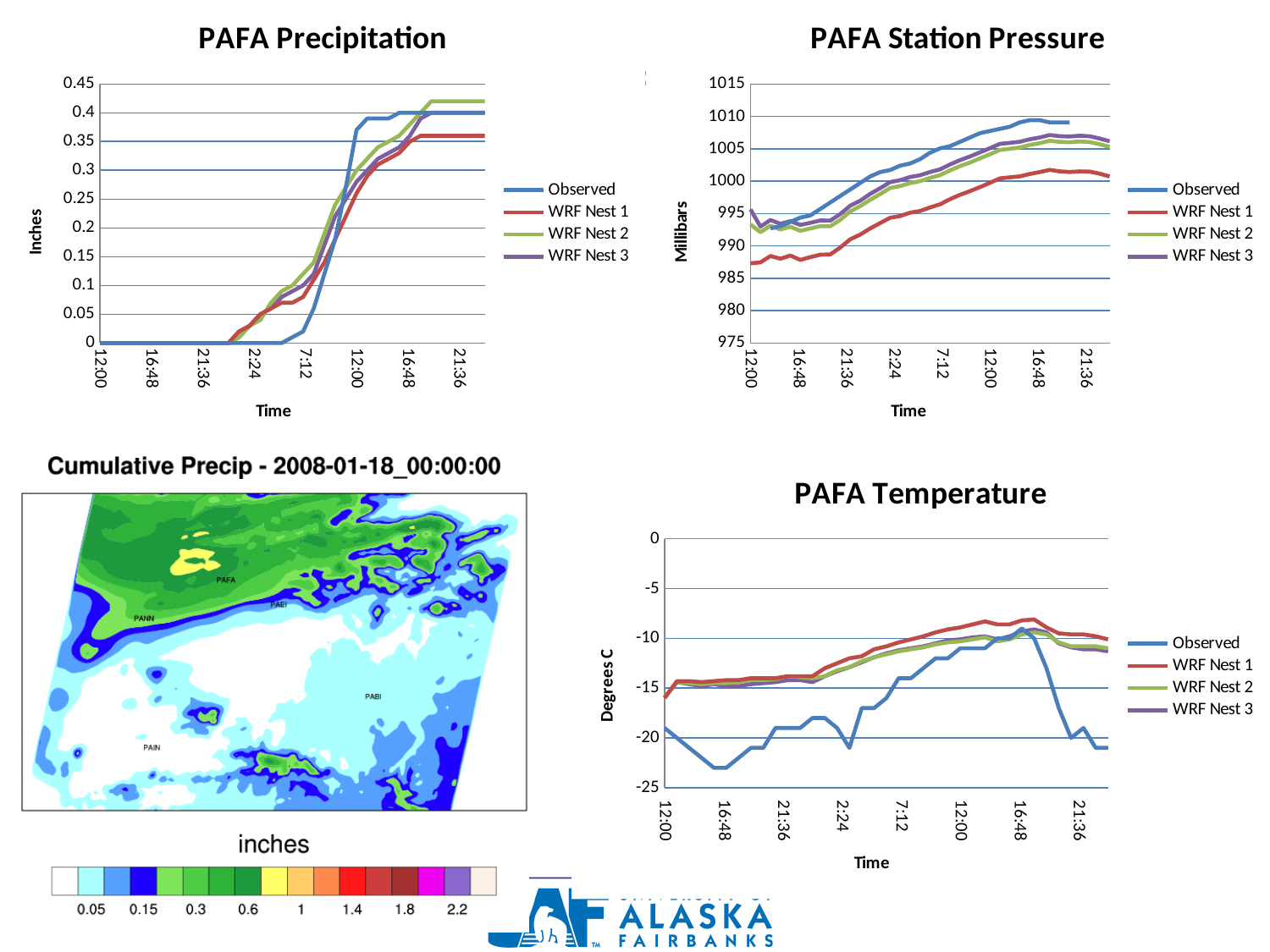
In the PAFA Station Pressure chart, is the WRF Nest 1 value at 12:00 (the first tick) greater or less than 990? less What is the y-axis label of the PAFA Station Pressure chart? Millibars In the PAFA Station Pressure chart, which series has the lowest values throughout? WRF Nest 1 In the PAFA Station Pressure chart, which series is higher at 16:48, Observed or WRF Nest 1? Observed What kind of chart is the PAFA Precipitation chart? line chart What is the y-axis label of the PAFA Temperature chart? Degrees C In the PAFA Precipitation chart, is the final Observed value at the right end greater or less than 0.35? greater In the PAFA Temperature chart, is the Observed value at 16:48 (the second tick) greater or less than -20? less In the PAFA Precipitation chart, which series ends higher at the right end, WRF Nest 1 or WRF Nest 2? WRF Nest 2 In the PAFA Station Pressure chart, does the Observed series generally rise or fall along the x axis? rise How many series does the legend of the PAFA Station Pressure chart list? 4